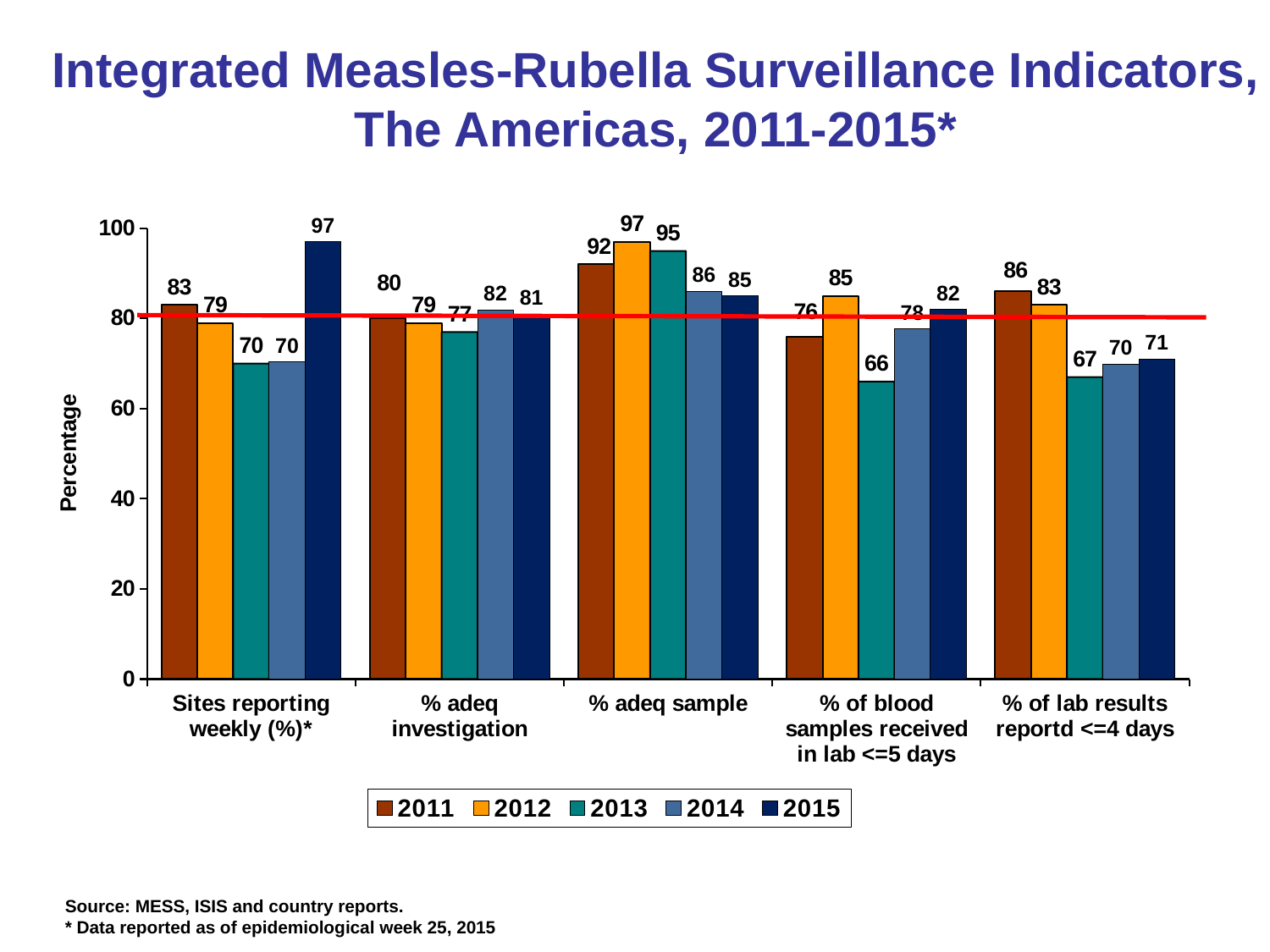
Which year has the lowest value in the "% of lab results reportd <=4 days" category? 2013 Which year has the highest value in the "% adeq sample" category? 2012 How many series does the legend list? 5 What is the value for 2014 in the "% adeq investigation" category? 82 What is the label of the y axis? Percentage Is the 2013 value for "% of blood samples received in lab <=5 days" greater or less than 80? less Which is larger in the "% adeq sample" category: the 2011 value or the 2014 value? 2011 What is the difference between the 2011 and 2013 values in the "% of lab results reportd <=4 days" category? 19 How many categories are shown on the x axis? 5 What kind of chart is shown on the slide? bar chart What is the value for 2015 in the "Sites reporting weekly (%)*" category? 97 What is the value for 2013 in the "% of blood samples received in lab <=5 days" category? 66